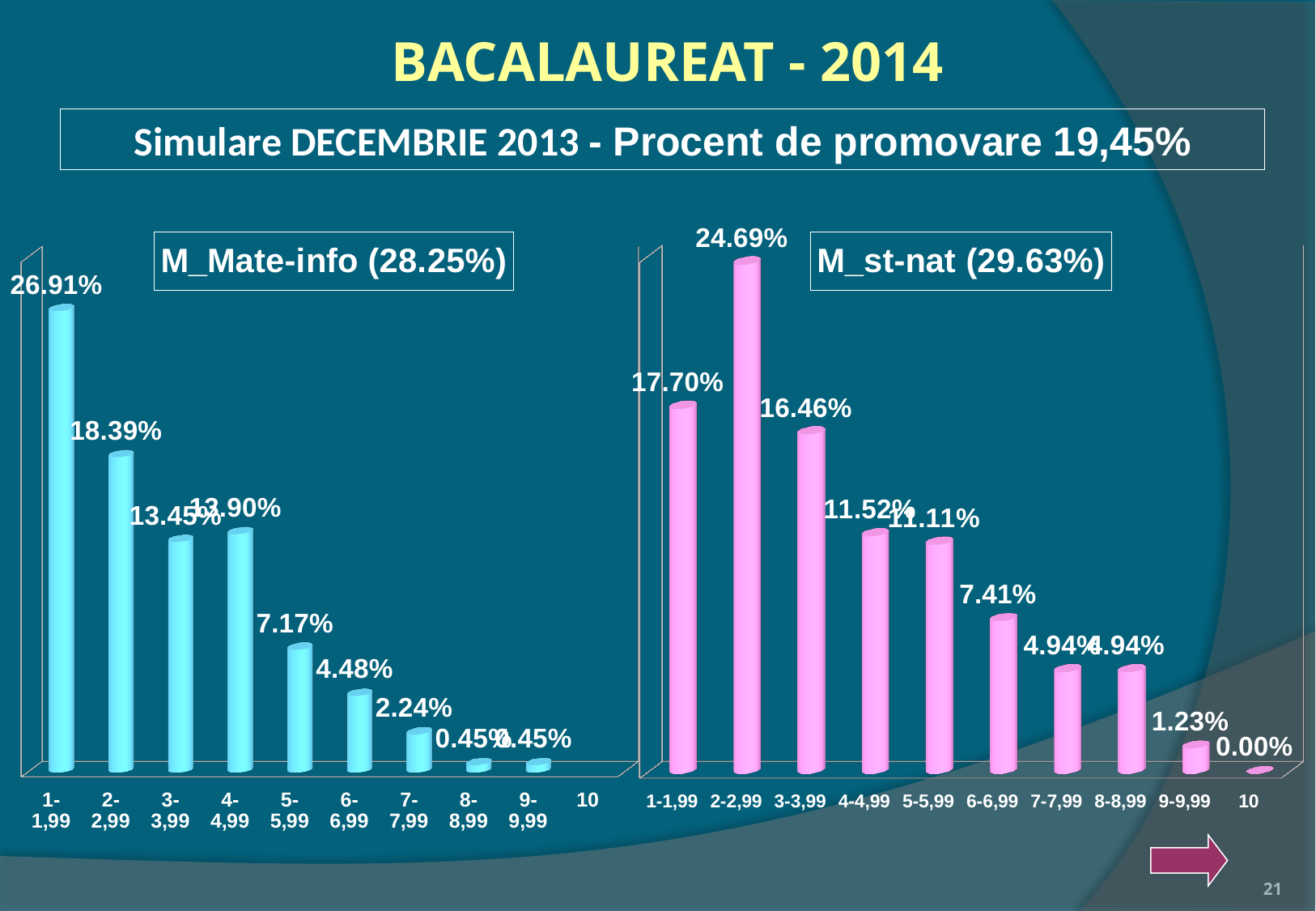
In the M_Mate-info chart, which category has the highest value? 1-1,99 In the M_st-nat chart, what is the value for the 2-2,99 category? 24.69% In the M_st-nat chart, which category has the highest value? 2-2,99 In the M_st-nat chart, what is the difference between the values for 1-1,99 and 3-3,99? 1.24% How many categories are shown on the x axis of the M_st-nat chart? 10 What kind of chart is the M_Mate-info chart? Bar chart In the M_Mate-info chart, which is larger: the value for 3-3,99 or the value for 4-4,99? 4-4,99 In the M_Mate-info chart, what is the value for the 5-5,99 category? 7.17% In the M_st-nat chart, which category has the lowest value? 10 In the M_Mate-info chart, what is the difference between the values for 2-2,99 and 3-3,99? 4.94% In the M_st-nat chart, what is the value for the 6-6,99 category? 7.41% In the M_Mate-info chart, what is the value for the 1-1,99 category? 26.91%